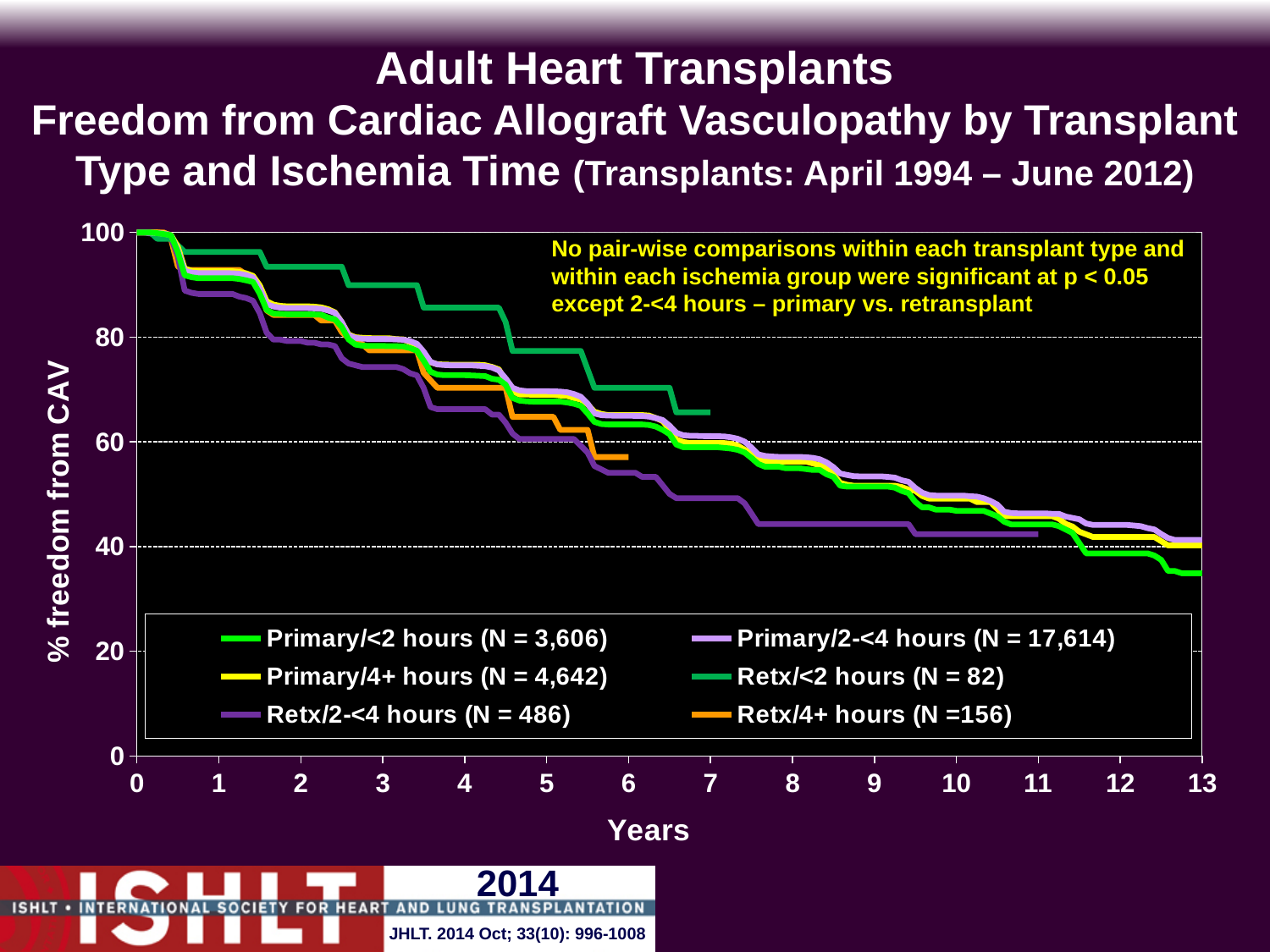
Is the value for Retx/<2 hours at year 7 greater or less than 60? greater What kind of chart is shown on the slide? line chart Which series has the highest % freedom from CAV at year 6? Retx/<2 hours Is the value for Retx/4+ hours at year 6 greater or less than 60? less Which series has the lowest % freedom from CAV at year 8? Retx/2-<4 hours How many series does the legend list? 6 Is the value for Primary/<2 hours at year 13 greater or less than 40? less Do the curves rise or fall as the years increase along the x axis? fall According to the legend, what is N for the Primary/2-<4 hours series? 17,614 At year 7, which is higher: Retx/<2 hours or Retx/2-<4 hours? Retx/<2 hours